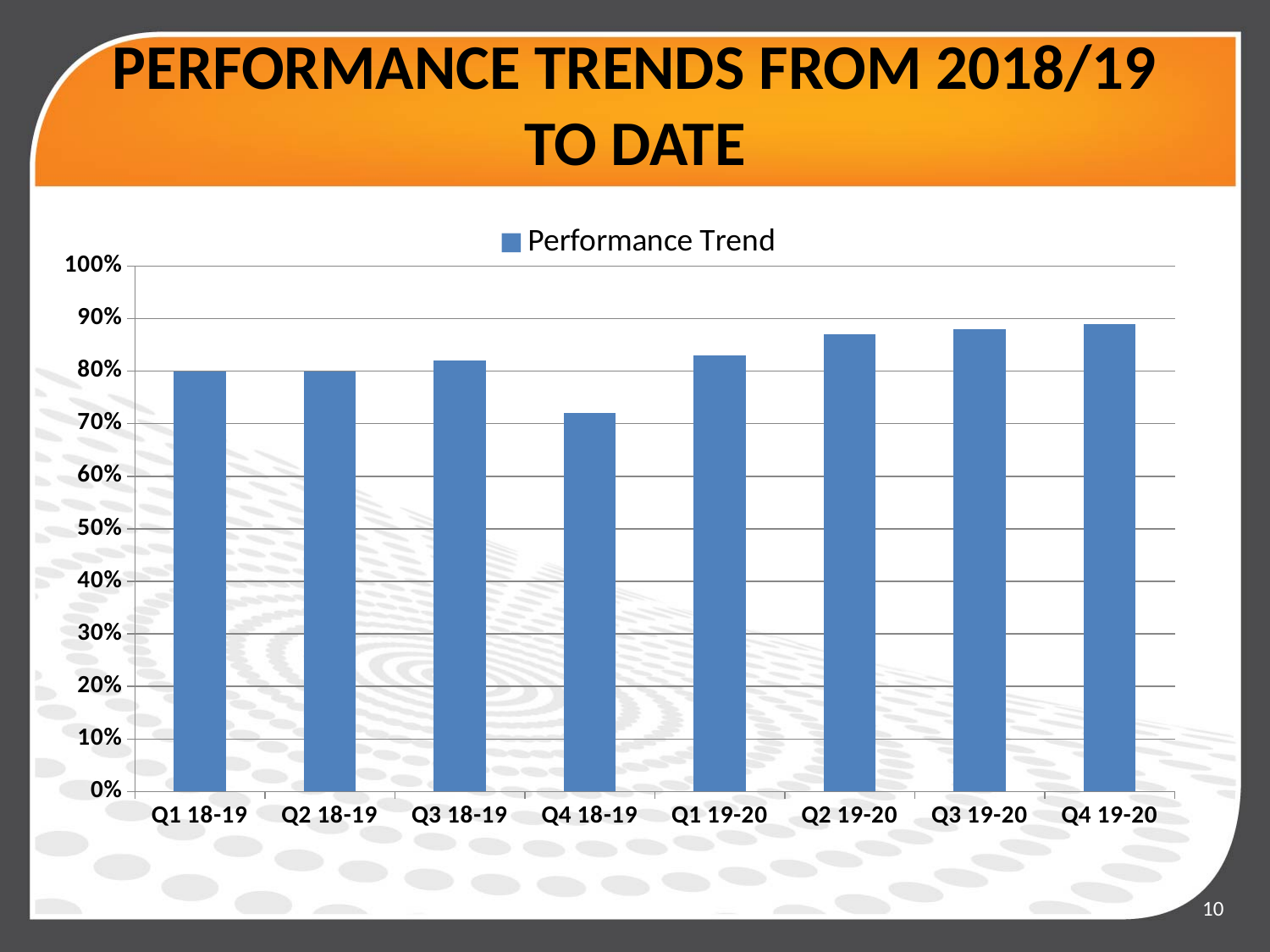
Which is larger, the value for Q4 18-19 or the value for Q1 19-20? Q1 19-20 Do the values rise or fall from Q4 18-19 through Q4 19-20? rise Is the value for Q4 18-19 greater or less than 70%? greater Which quarter has the lowest value in the chart? Q4 18-19 Is the value for Q4 18-19 greater or less than 80%? less What kind of chart is shown on the slide? bar chart How many series does the chart legend list? 1 What is the name of the series shown in the chart legend? Performance Trend Is the value for Q2 19-20 greater or less than 80%? greater How many quarters are plotted on the x axis of the chart? 8 Which is larger, the value for Q1 18-19 or the value for Q3 19-20? Q3 19-20